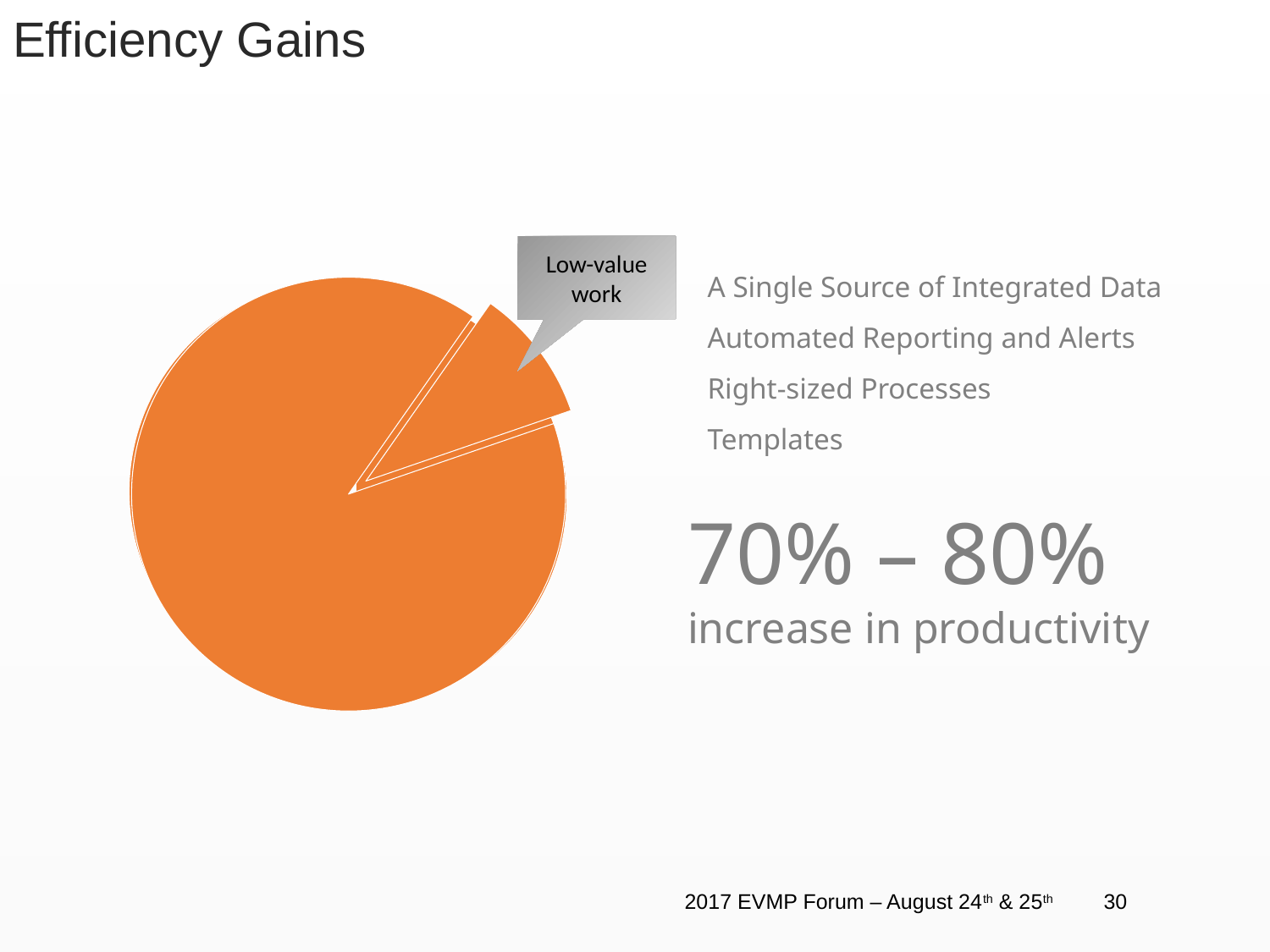
Which slice of the pie chart is labelled with a callout? Low-value work How many slices does the pie chart have? 2 What kind of chart is shown on the slide? pie chart What colour are the slices of the pie chart? orange Is the 'Low-value work' slice separated (exploded) from the rest of the pie? yes Is the slice labelled 'Low-value work' the larger or the smaller slice of the pie? smaller